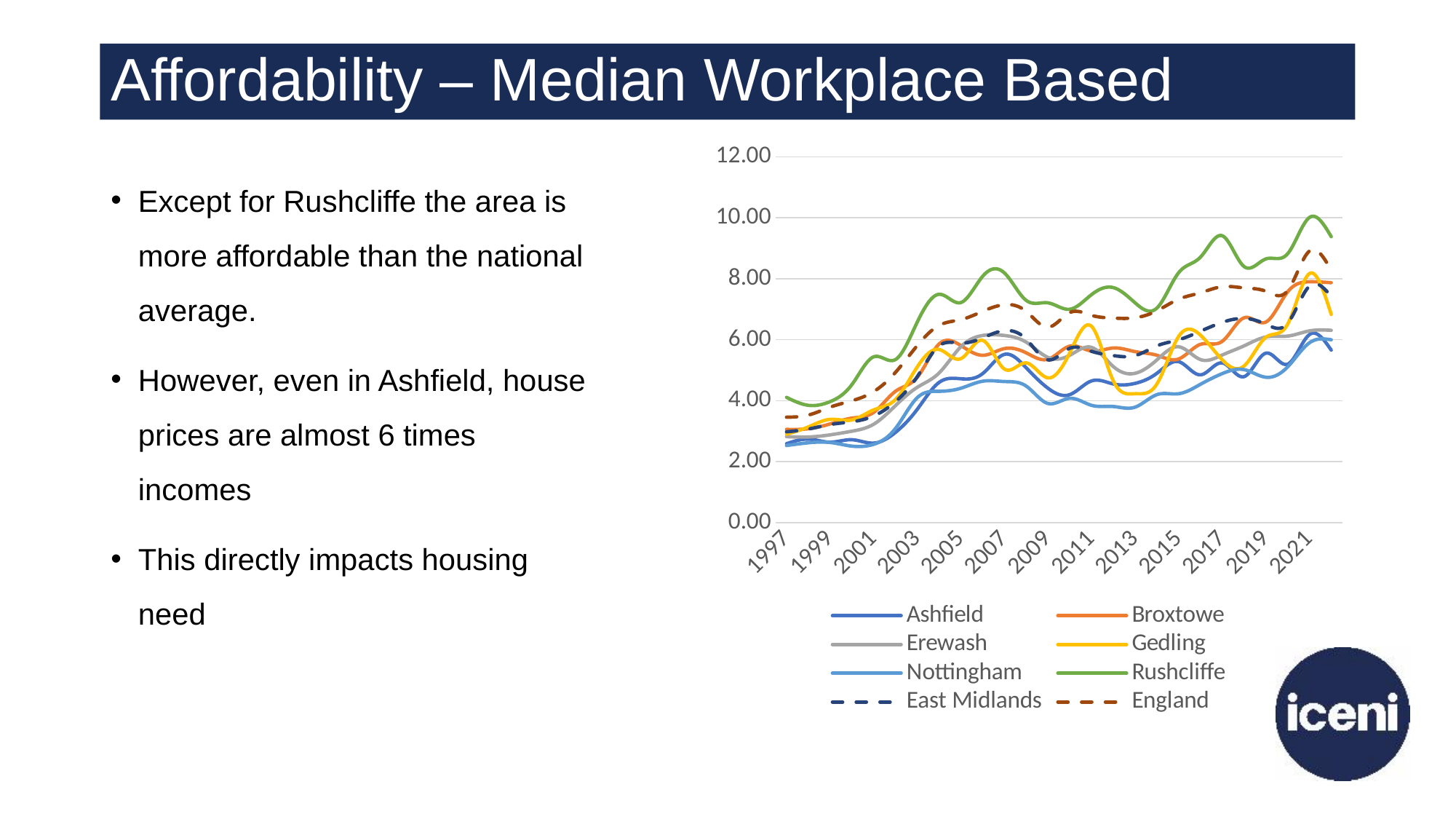
Is the value for Rushcliffe in 2021 greater or less than 8.00? greater In 2017, which is larger: the value for Rushcliffe or the value for Ashfield? Rushcliffe Which series has the lowest value in 2013? Nottingham Is the value for England in 2007 greater or less than 6.00? greater How many series does the chart's legend list? 8 Does the Rushcliffe line generally rise or fall from 1997 to 2021? rise Which series has the highest value in 2021? Rushcliffe In 2007, which is larger: the value for England or the value for East Midlands? England Which two series are drawn with dashed lines? East Midlands and England Is the value for Ashfield in 1997 greater or less than 4.00? less What kind of chart is shown on the slide? line chart